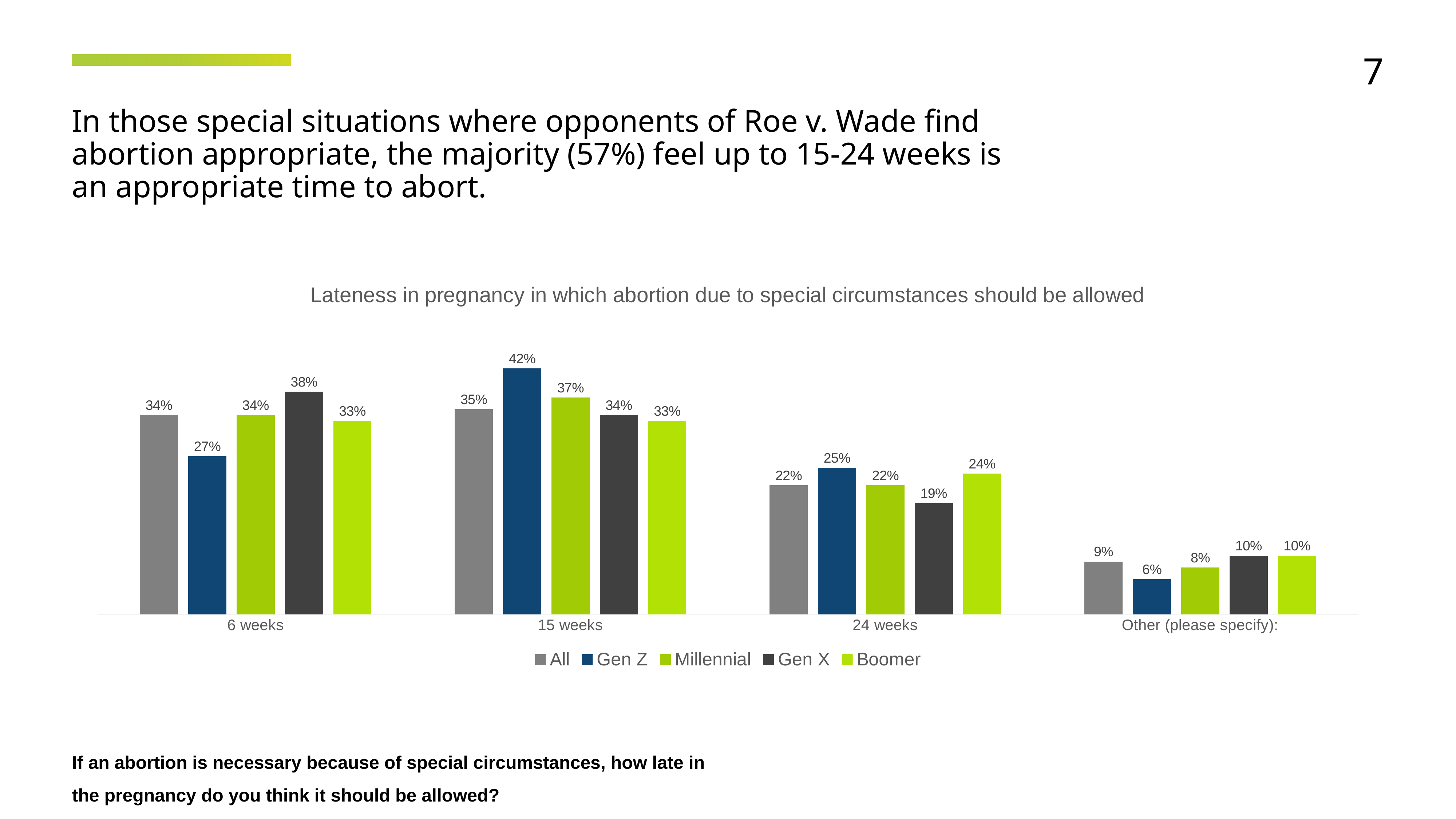
What is the difference between the Gen Z value at 15 weeks and the Gen Z value at 6 weeks? 15% What is the value for Gen Z at 15 weeks? 42% How many categories are shown on the x axis? 4 Which is larger: the Millennial value at 15 weeks or the Gen X value at 15 weeks? Millennial What is the title of the chart? Lateness in pregnancy in which abortion due to special circumstances should be allowed Which series has the highest value at 15 weeks? Gen Z What is the value for Gen X at 6 weeks? 38% What kind of chart is shown on the slide? Bar chart How many series does the legend list? 5 What is the value for All in the Other (please specify) category? 9% What is the value for Boomer at 24 weeks? 24% Which series has the lowest value at 6 weeks? Gen Z